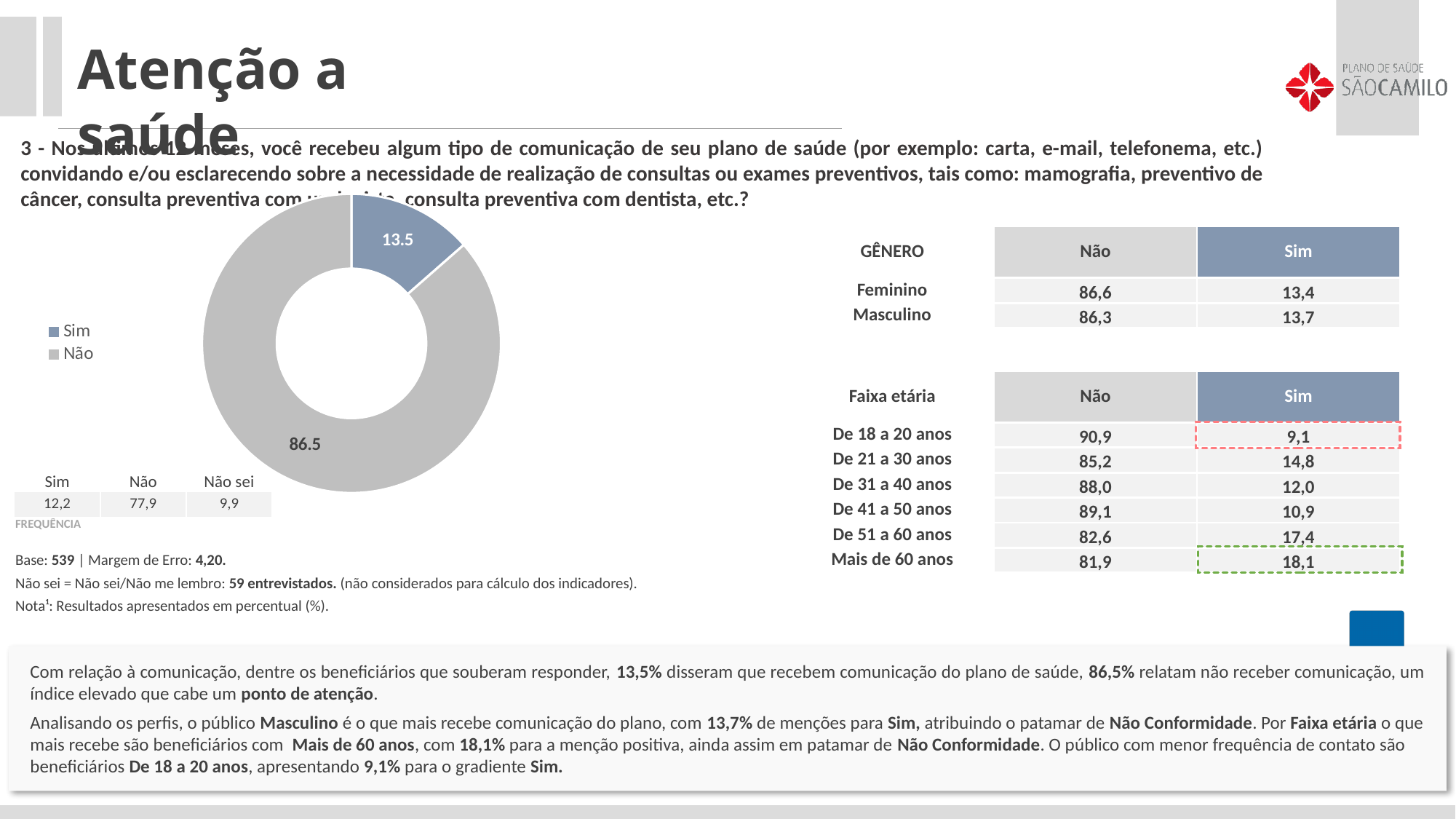
How many entries does the legend of the doughnut chart list? 2 What is the total of the two values shown in the doughnut chart? 100 What kind of chart is shown on the slide? Doughnut chart Which slice of the doughnut chart is the largest? Não Which legend entry of the doughnut chart is shown in blue? Sim Which slice of the doughnut chart is the smallest? Sim In the doughnut chart, which is larger: "Sim" or "Não"? Não What is the difference between the "Não" and "Sim" values in the doughnut chart? 73 What is the value shown for "Não" in the doughnut chart? 86.5 How many slices does the doughnut chart have? 2 Which legend entry of the doughnut chart is shown in grey? Não What is the value shown for "Sim" in the doughnut chart? 13.5